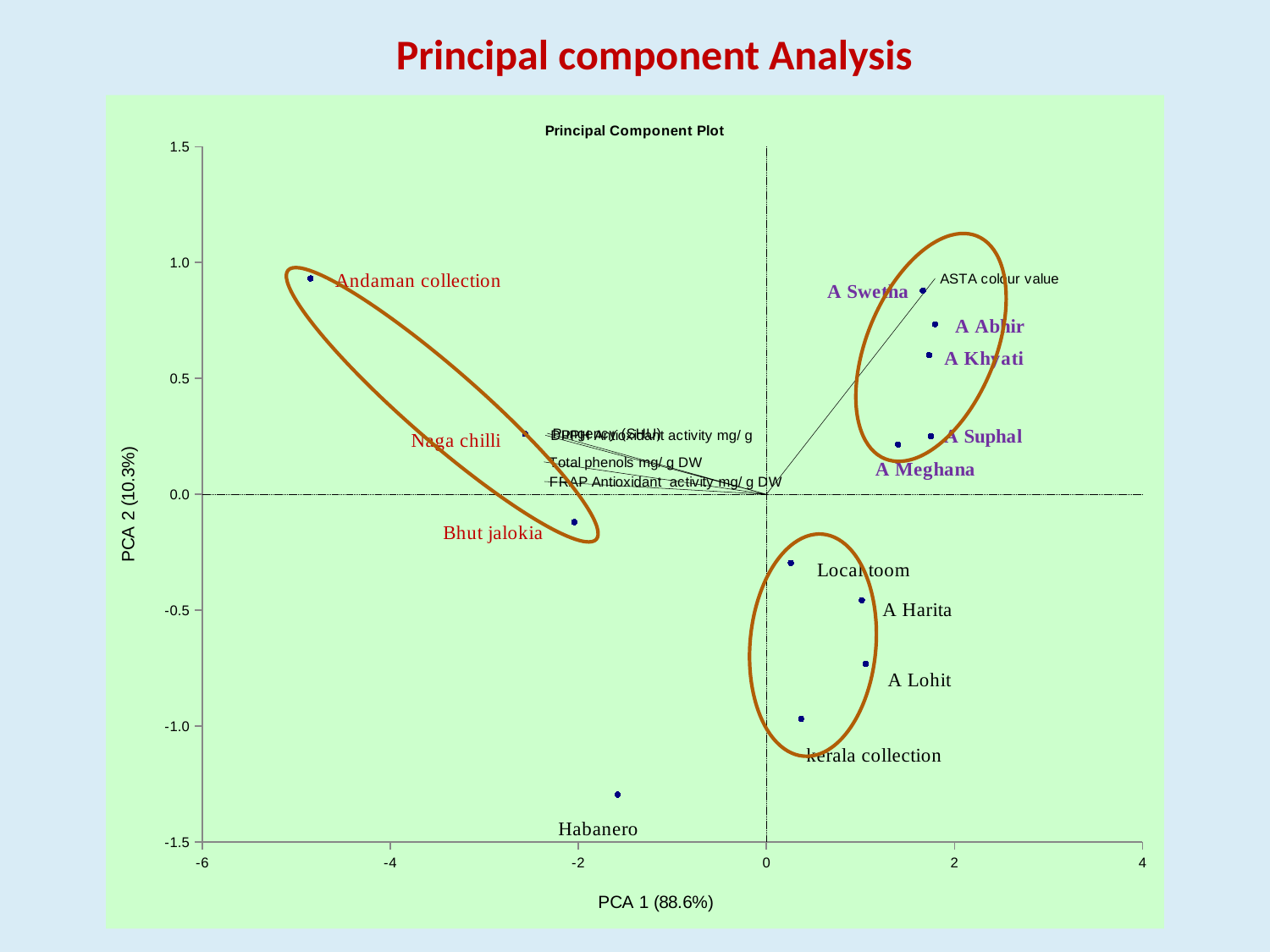
Which has the larger PCA 2 value, Bhut jalokia or Habanero? Bhut jalokia Is the PCA 2 value for A Swetha greater or less than 0.5? greater Is the PCA 2 value for Habanero greater or less than -1.0? less Which labelled point has the lowest PCA 1 value? Andaman collection Which has the larger PCA 1 value, Naga chilli or Andaman collection? Naga chilli How many groups of points are circled on the chart? 3 What kind of chart is shown on the slide? scatter plot Is the PCA 2 value for kerala collection greater or less than -0.5? less Which labelled point has the lowest PCA 2 value? Habanero What percentage of variance is shown for PCA 1 on the x-axis label? 88.6% How many labelled data points are plotted on the chart? 13